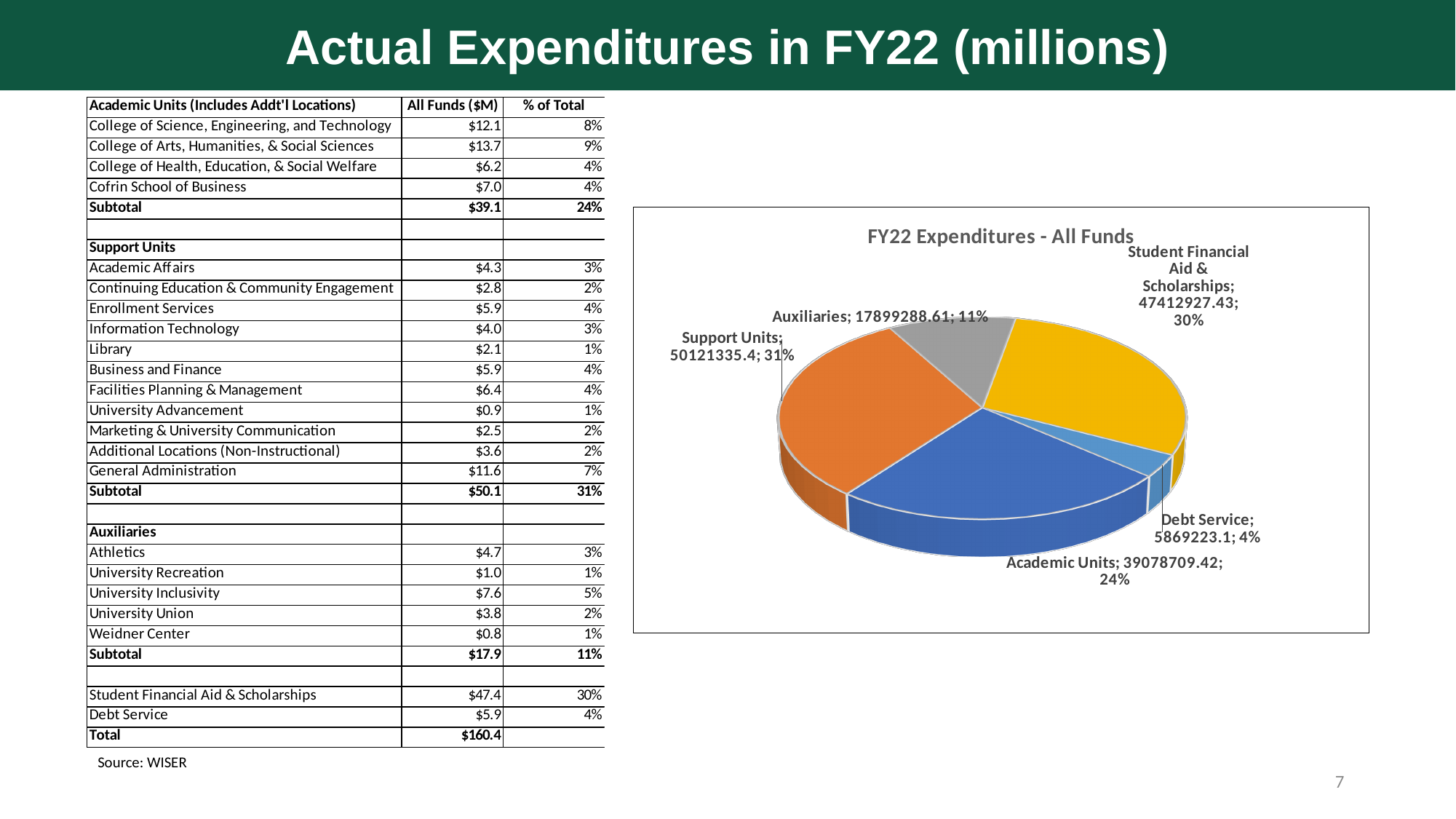
What value is labelled for Debt Service in the pie chart? 5869223.1 What kind of chart is shown on the slide? Pie chart What value is labelled for Academic Units in the pie chart? 39078709.42 How many slices does the pie chart have? 5 What share of the pie does Support Units represent? 31% What colour is the Student Financial Aid & Scholarships slice in the pie chart? Yellow What share of the pie does Student Financial Aid & Scholarships represent? 30% Which is larger in the pie chart, Academic Units or Auxiliaries? Academic Units What is the title of the pie chart? FY22 Expenditures - All Funds Which slice of the pie chart is the smallest? Debt Service What value is labelled for Auxiliaries in the pie chart? 17899288.61 What is the difference in percentage share between Academic Units and Auxiliaries in the pie chart? 13%